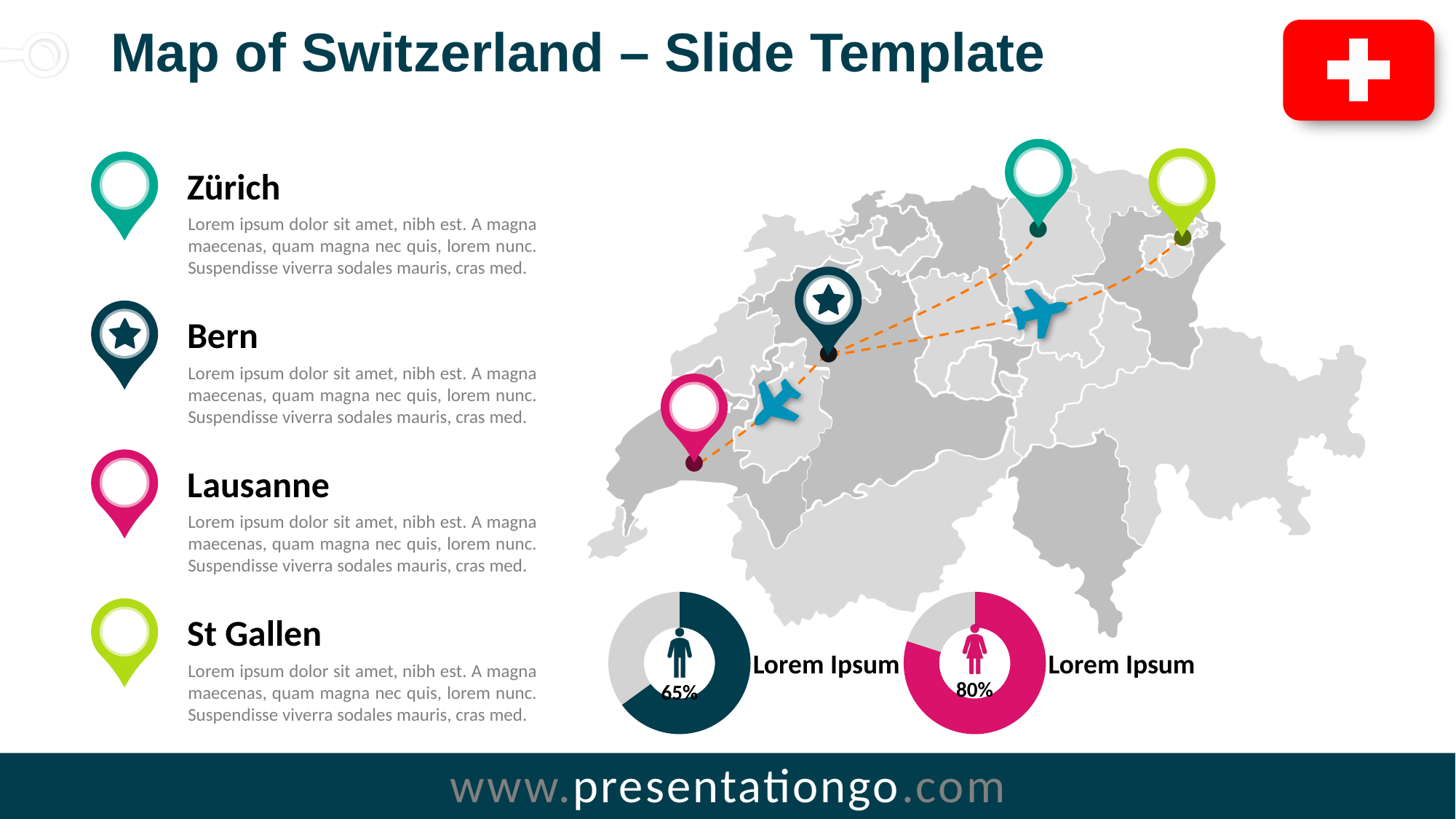
What percentage is shown in the left donut chart (with the male figure icon)? 65% What label appears next to the left donut chart? Lorem Ipsum How many donut charts are shown on the slide? 2 What share of the right donut chart is not filled in pink? 20% In the left donut chart, is the filled share greater or less than 50%? greater What kind of chart are the two charts at the bottom of the slide? Donut chart What percentage is shown in the right donut chart (with the female figure icon)? 80% What colour is the filled portion of the right donut chart? Pink Which of the two donut charts shows the higher percentage, the left one or the right one? The right one What is the difference between the percentage in the right donut chart and the percentage in the left donut chart? 15%